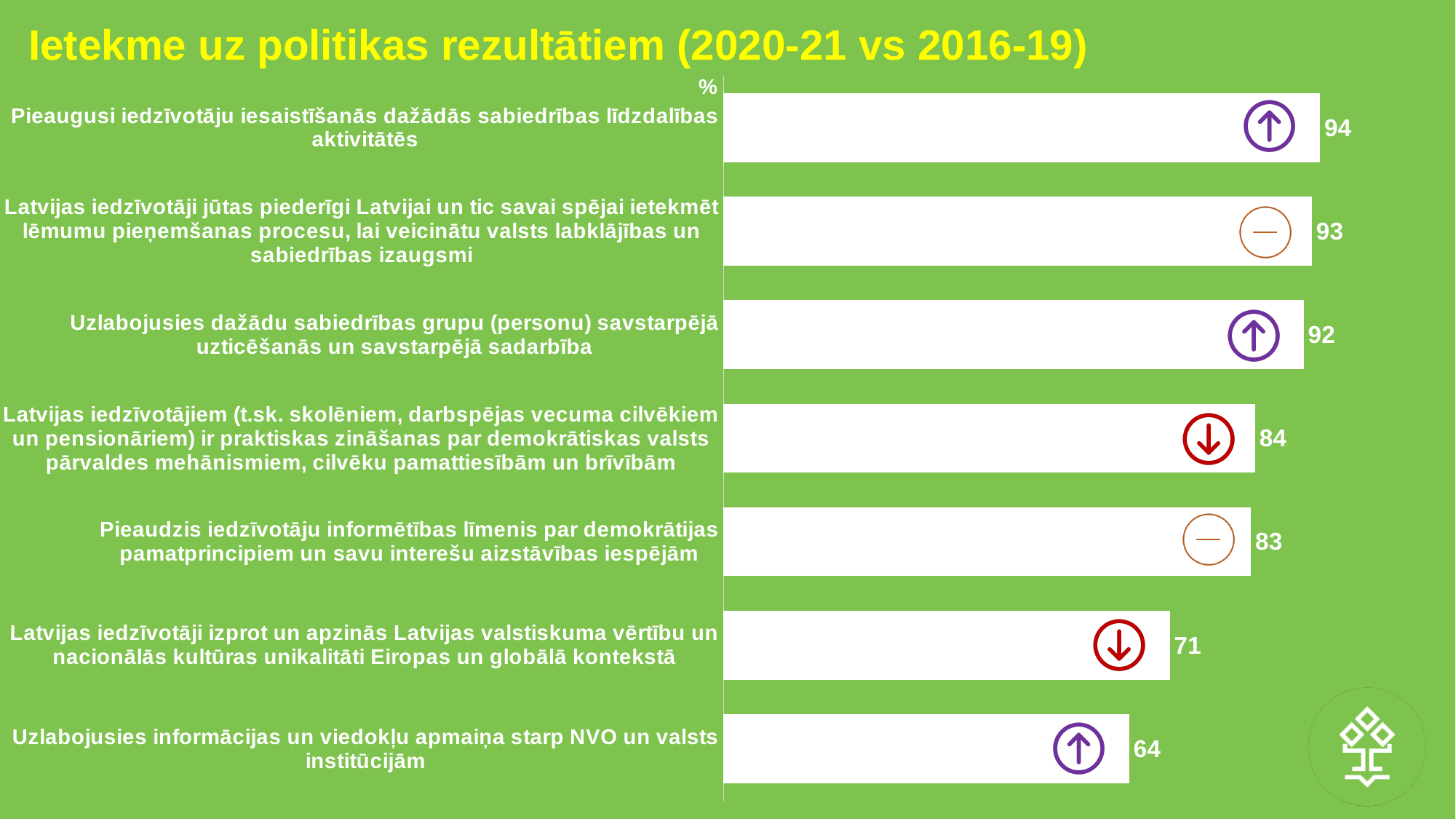
What is the difference between the values for "Latvijas iedzīvotājiem (t.sk. skolēniem, darbspējas vecuma cilvēkiem un pensionāriem) ir praktiskas zināšanas..." (84) and "Pieaudzis iedzīvotāju informētības līmenis..." (83)? 1 How many categories are shown in the chart? 7 Which category has the highest value? Pieaugusi iedzīvotāju iesaistīšanās dažādās sabiedrības līdzdalības aktivitātēs What is the value for "Pieaugusi iedzīvotāju iesaistīšanās dažādās sabiedrības līdzdalības aktivitātēs"? 94 What is the value for "Uzlabojusies informācijas un viedokļu apmaiņa starp NVO un valsts institūcijām"? 64 What is the difference between the highest value (94) and the lowest value (64)? 30 What is the title of the slide? Ietekme uz politikas rezultātiem (2020-21 vs 2016-19) Which is larger: the value for "Latvijas iedzīvotāji izprot un apzinās Latvijas valstiskuma vērtību..." or the value for "Uzlabojusies informācijas un viedokļu apmaiņa starp NVO un valsts institūcijām"? Latvijas iedzīvotāji izprot un apzinās Latvijas valstiskuma vērtību un nacionālās kultūras unikalitāti Eiropas un globālā kontekstā What is the value for "Uzlabojusies dažādu sabiedrības grupu (personu) savstarpējā uzticēšanās un savstarpējā sadarbība"? 92 What kind of chart is shown on the slide? Bar chart What is the value for "Latvijas iedzīvotāji izprot un apzinās Latvijas valstiskuma vērtību un nacionālās kultūras unikalitāti Eiropas un globālā kontekstā"? 71 Which category has the lowest value? Uzlabojusies informācijas un viedokļu apmaiņa starp NVO un valsts institūcijām